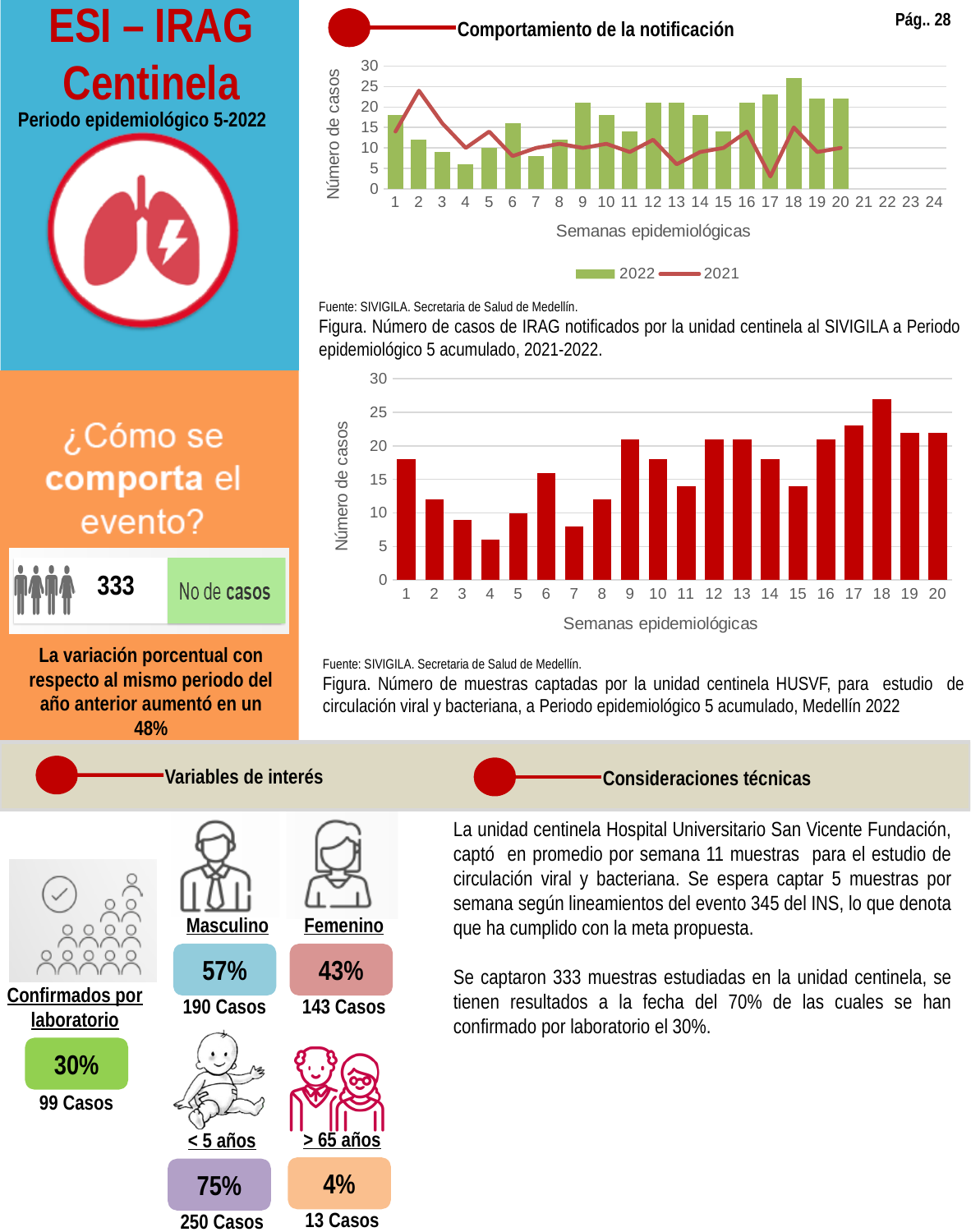
In the top chart, is the 2021 value for week 17 greater or less than 5? less In the top chart, at week 2, which is larger: the 2022 bar or the 2021 line? 2021 In the top chart, which week has the highest 2022 bar? 18 In the bottom chart, is the value for week 18 greater or less than 25? greater In the bottom chart (Número de muestras captadas), which week has the lowest bar? 4 In the bottom chart, how many weeks (bars) are plotted? 20 What kind of chart is the bottom chart (Número de muestras captadas)? Bar chart In the bottom chart (Número de muestras captadas), which week has the highest bar? 18 In the bottom chart, is the value for week 4 greater or less than 10? less In the top chart (Comportamiento de la notificación), how many series does the legend list? 2 In the top chart, which series is shown as a line? 2021